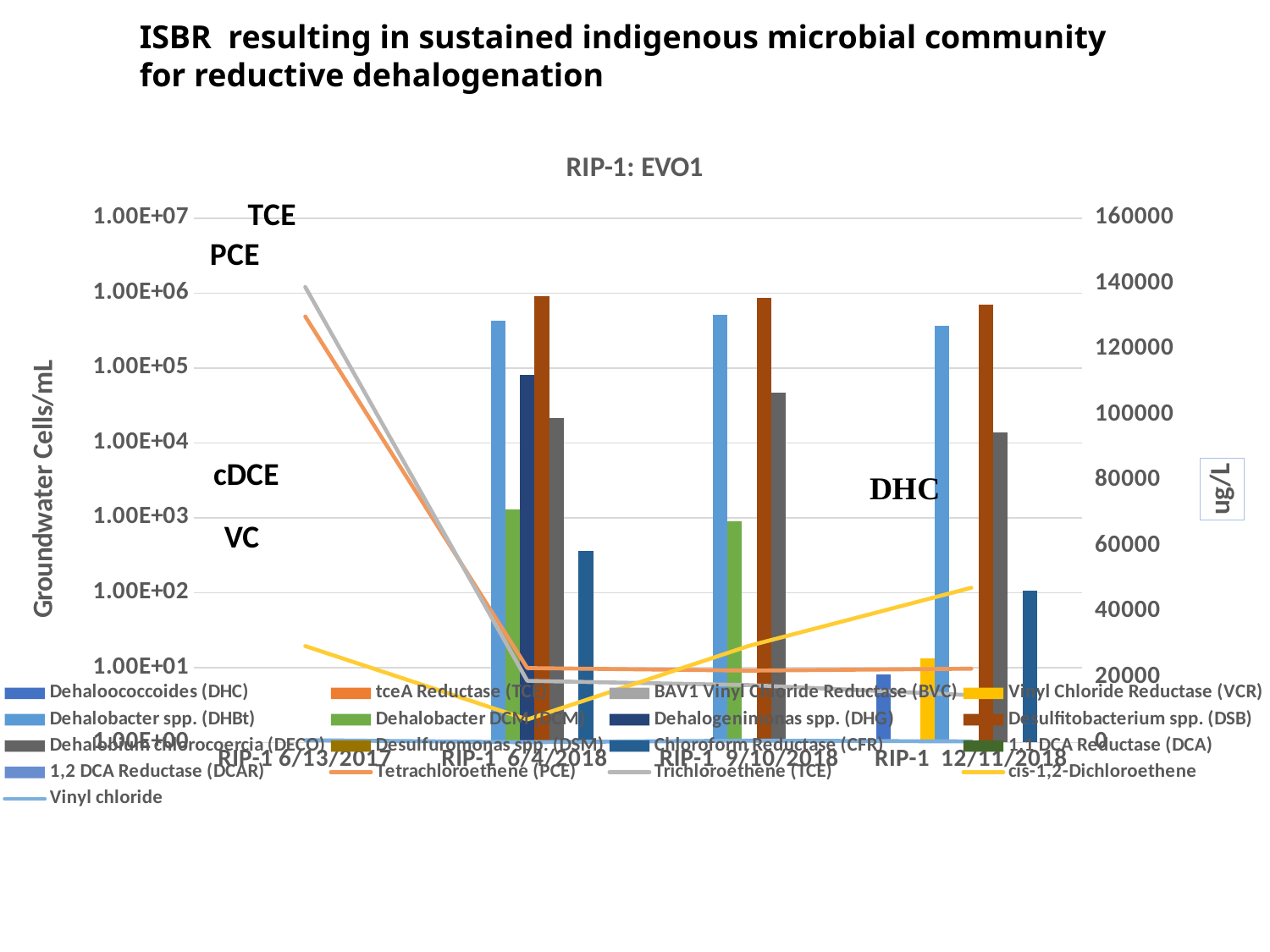
How many sampling dates (categories) are shown on the x axis? 4 Is the Chloroform Reductase (CFR) bar for RIP-1 6/4/2018 greater or less than 1.00E+03? less Is the Dehalogenimonas spp. (DHG) bar for RIP-1 6/4/2018 greater or less than 1.00E+05? less What is the label of the left vertical axis? Groundwater Cells/mL Does the Trichloroethene (TCE) line rise or fall from RIP-1 6/13/2017 to RIP-1 6/4/2018? fall Which bar is the tallest for RIP-1 6/4/2018? Desulfitobacterium spp. (DSB) Is the cis-1,2-Dichloroethene line value for RIP-1 12/11/2018 greater or less than 40000 ug/L? greater What kind of chart is shown on the slide? Combination bar and line chart What is the title of the chart? RIP-1: EVO1 How many series does the legend list? 17